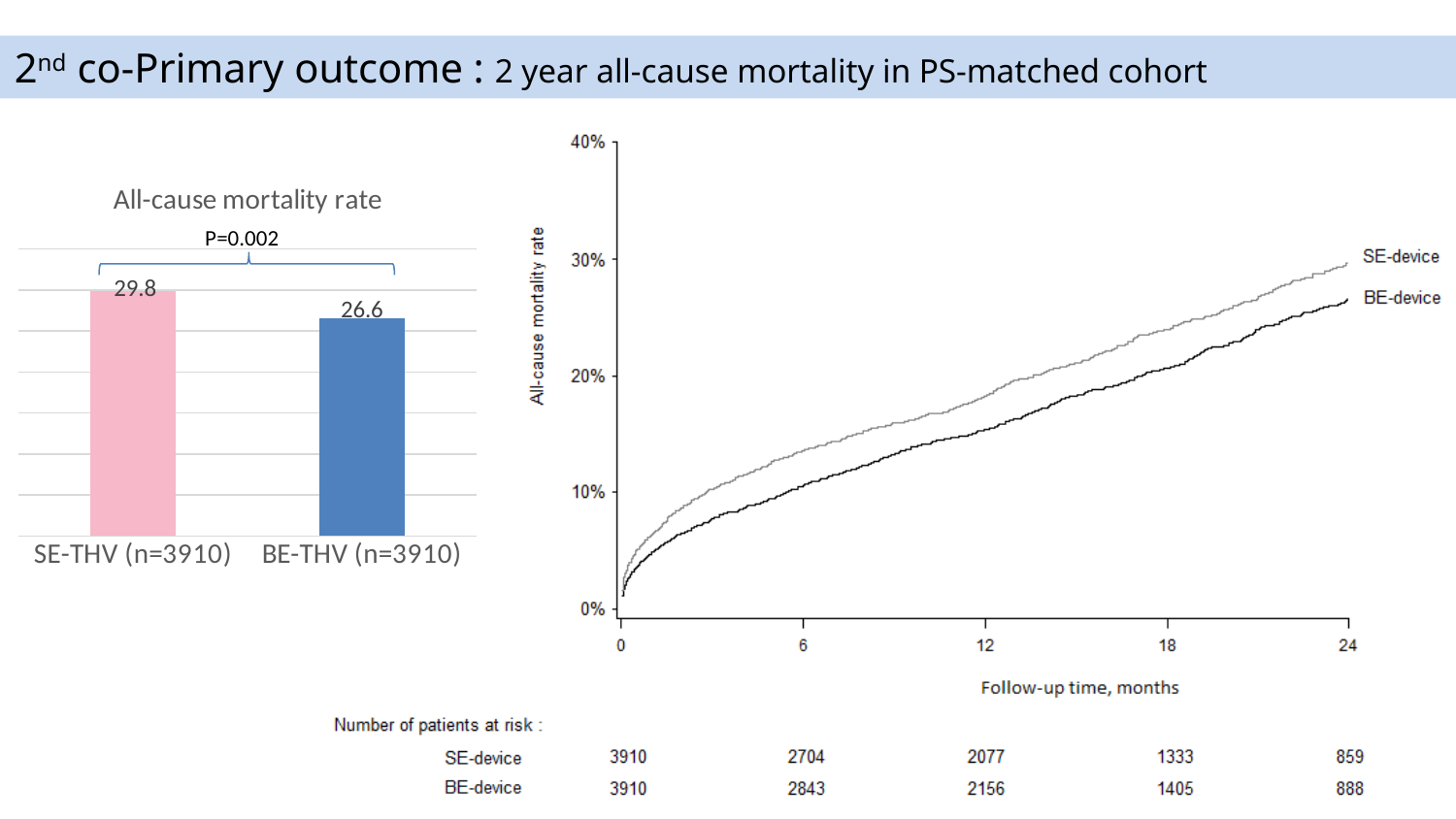
In the bar chart titled "All-cause mortality rate", which category has the higher value? SE-THV (n=3910) In the bar chart titled "All-cause mortality rate", what is the value for SE-THV (n=3910)? 29.8 In the line chart on the right, is the SE-device value at 24 months greater or less than 20%? greater What kind of chart is the chart on the left of the slide? Bar chart In the bar chart titled "All-cause mortality rate", what is the value for BE-THV (n=3910)? 26.6 In the line chart on the right, do the all-cause mortality curves rise or fall as follow-up time increases? Rise In the bar chart titled "All-cause mortality rate", how many bars are plotted? 2 In the line chart on the right, which series has the higher all-cause mortality rate at 24 months, SE-device or BE-device? SE-device In the bar chart titled "All-cause mortality rate", what P-value is shown above the bars? P=0.002 In the bar chart titled "All-cause mortality rate", what is the difference between the SE-THV and BE-THV values? 3.2 In the bar chart titled "All-cause mortality rate", which category has the lower value? BE-THV (n=3910) In the line chart on the right, how many series are labelled? 2